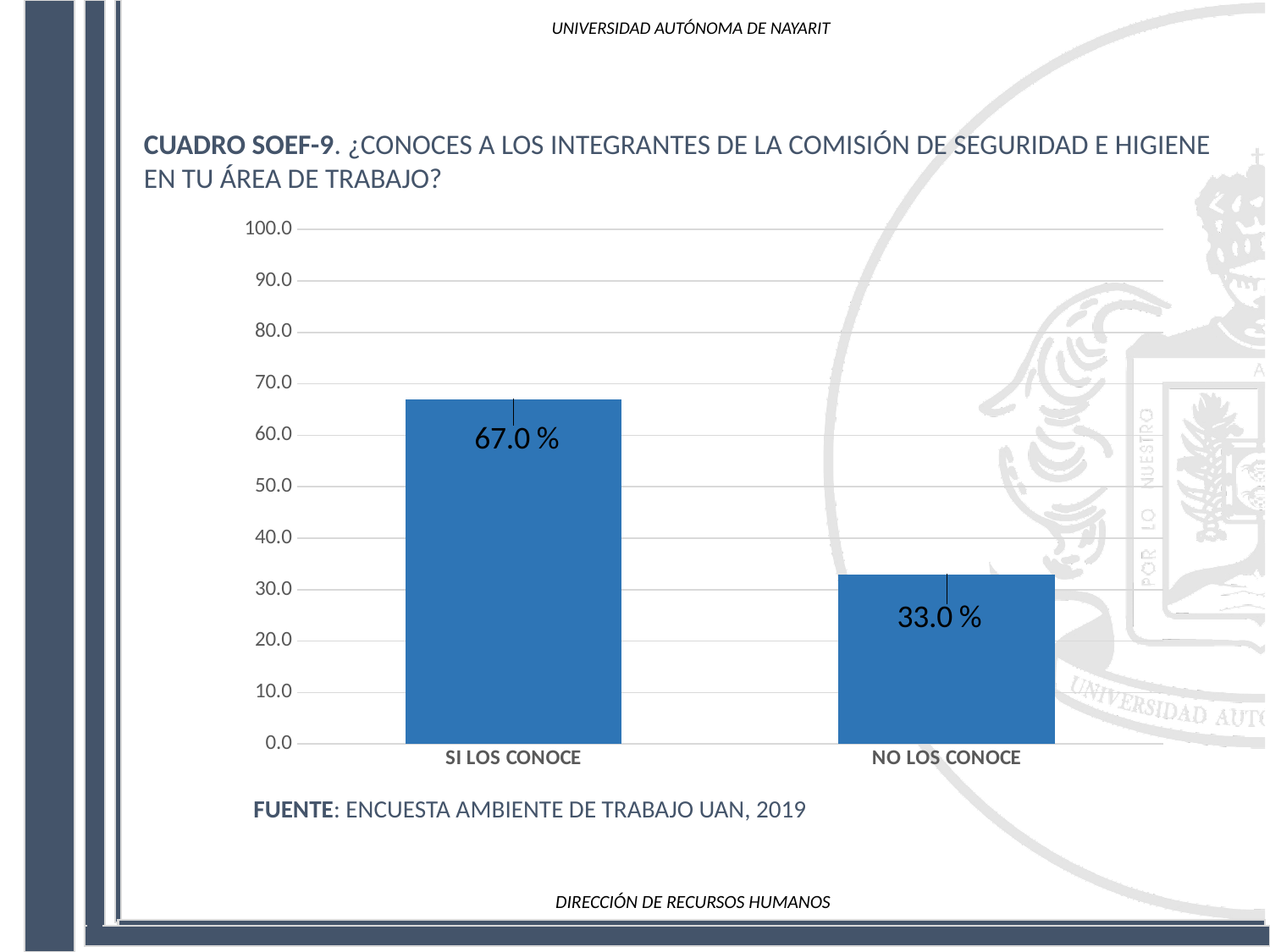
Which category has the lowest value? NO LOS CONOCE How many categories are shown on the x axis? 2 What source is cited below the chart? ENCUESTA AMBIENTE DE TRABAJO UAN, 2019 Is the value for SI LOS CONOCE greater or less than 60.0? greater What kind of chart is shown on the slide? bar chart What is the value for NO LOS CONOCE? 33.0 % What is the value for SI LOS CONOCE? 67.0 % Which is larger, the value for SI LOS CONOCE or the value for NO LOS CONOCE? SI LOS CONOCE What is the total of the two values shown in the chart? 100.0 % Is the value for NO LOS CONOCE greater or less than 40.0? less What is the difference between the values for SI LOS CONOCE and NO LOS CONOCE? 34.0 % Which category has the highest value? SI LOS CONOCE